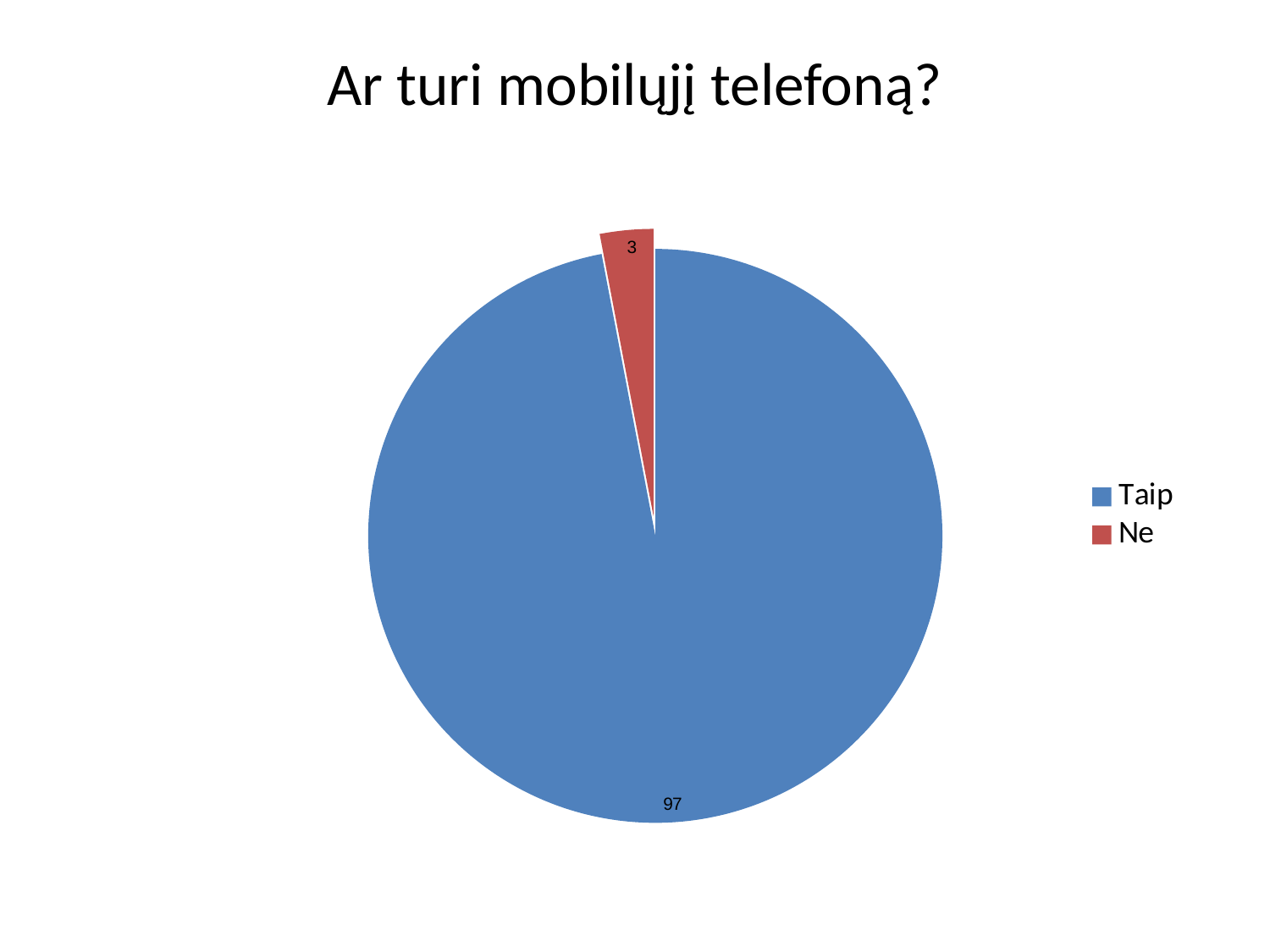
Which category has the smallest slice? Ne What is the difference between the values for Taip and Ne? 94 Which category has the largest slice? Taip What is the total of the two slice values? 100 What colour is the Ne slice? red What is the value for Ne? 3 How many categories does the pie chart show? 2 What type of chart is shown on the slide? pie chart Which is larger, the value for Taip or the value for Ne? Taip What is the value for Taip? 97 What is the title of the chart? Ar turi mobilųjį telefoną? What share of the pie does the Ne slice represent? 3%